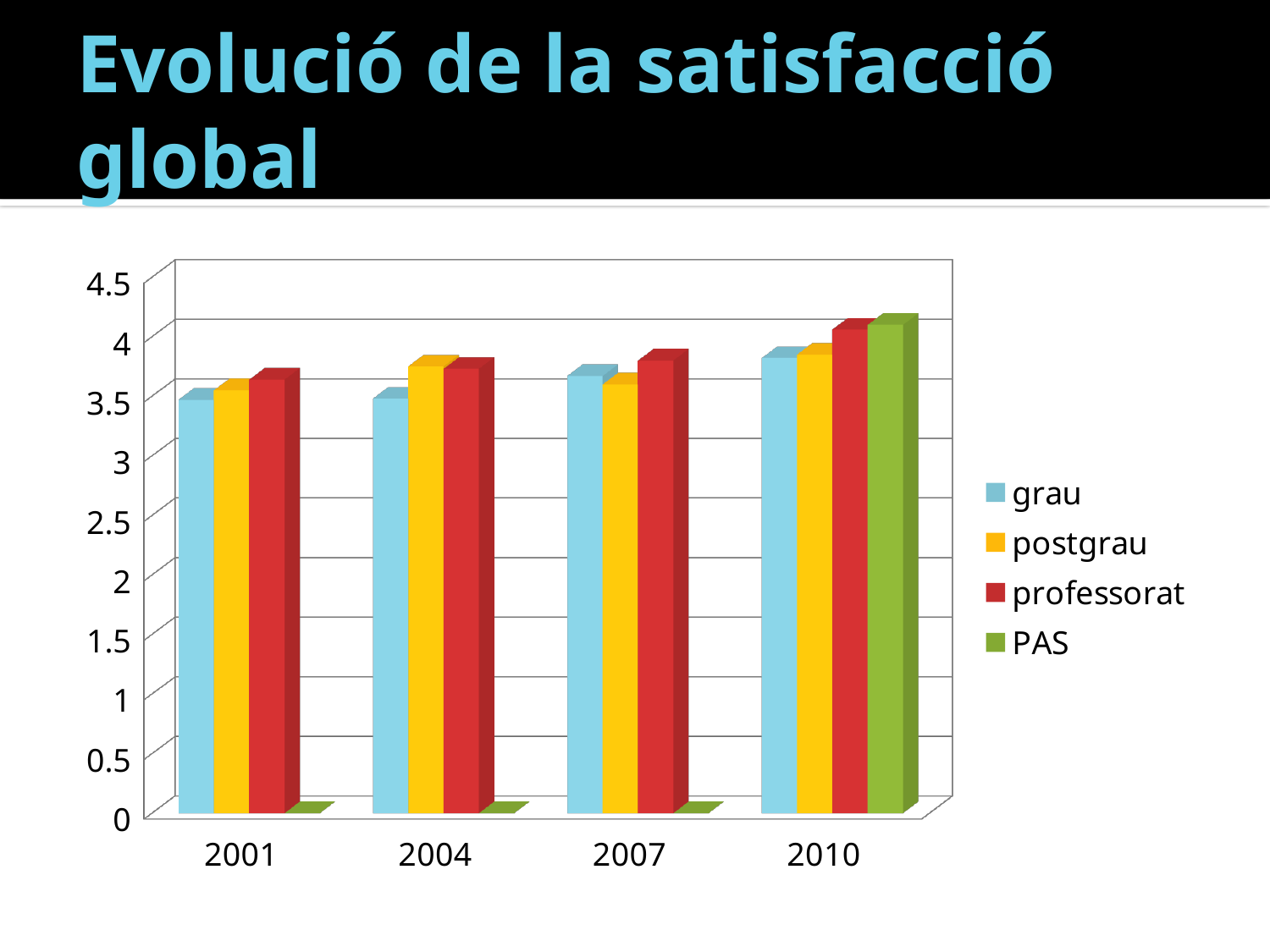
Which colour represents the PAS series in the chart? green Is the value for PAS in 2010 greater or less than 3.5? greater What is the title of the slide containing the chart? Evolució de la satisfacció global Is the value for grau in 2001 greater or less than 3? greater How many years are shown on the x axis of the chart? 4 Which is larger in 2007, the value for grau or the value for professorat? professorat How many series does the chart legend list? 4 Is the value for postgrau in 2004 greater or less than 3.5? greater What kind of chart is shown on the slide? bar chart In which year is the grau value highest? 2010 Does the grau series generally rise or fall from 2001 to 2010? rise